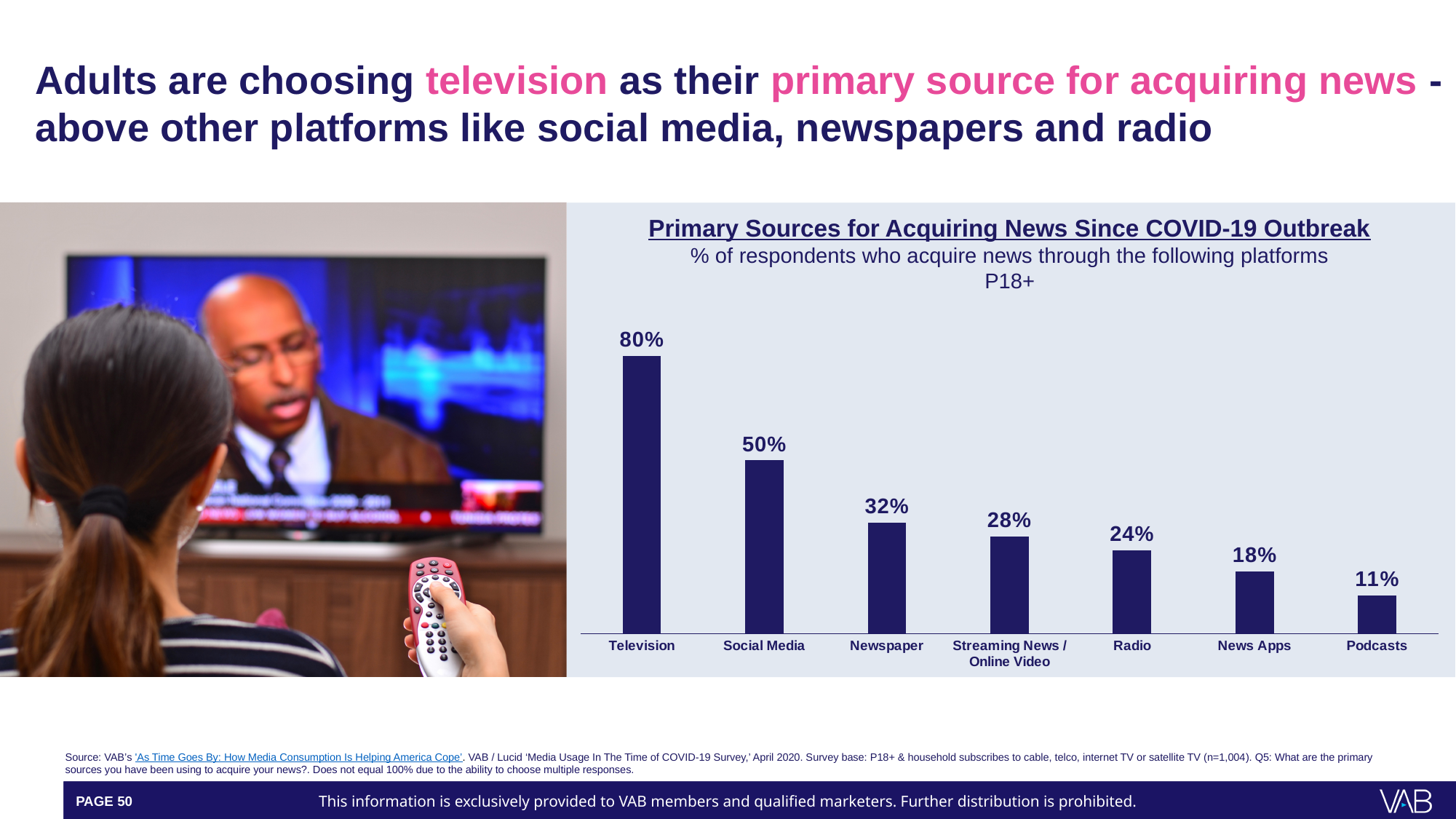
Which has a higher value, Radio or News Apps? Radio Do the values rise or fall from left to right across the platforms? Fall How many platforms are shown in the chart? 7 What is the value shown for Streaming News / Online Video? 28% What percentage of respondents acquire news through Television? 80% What percentage of respondents acquire news through Social Media? 50% What kind of chart is shown on the slide? Bar chart Which platform has the highest percentage of respondents? Television What is the value shown for News Apps? 18% Which platform has the lowest percentage of respondents? Podcasts What is the difference in percentage points between Television and Social Media? 30 What is the difference in percentage points between Newspaper and Radio? 8